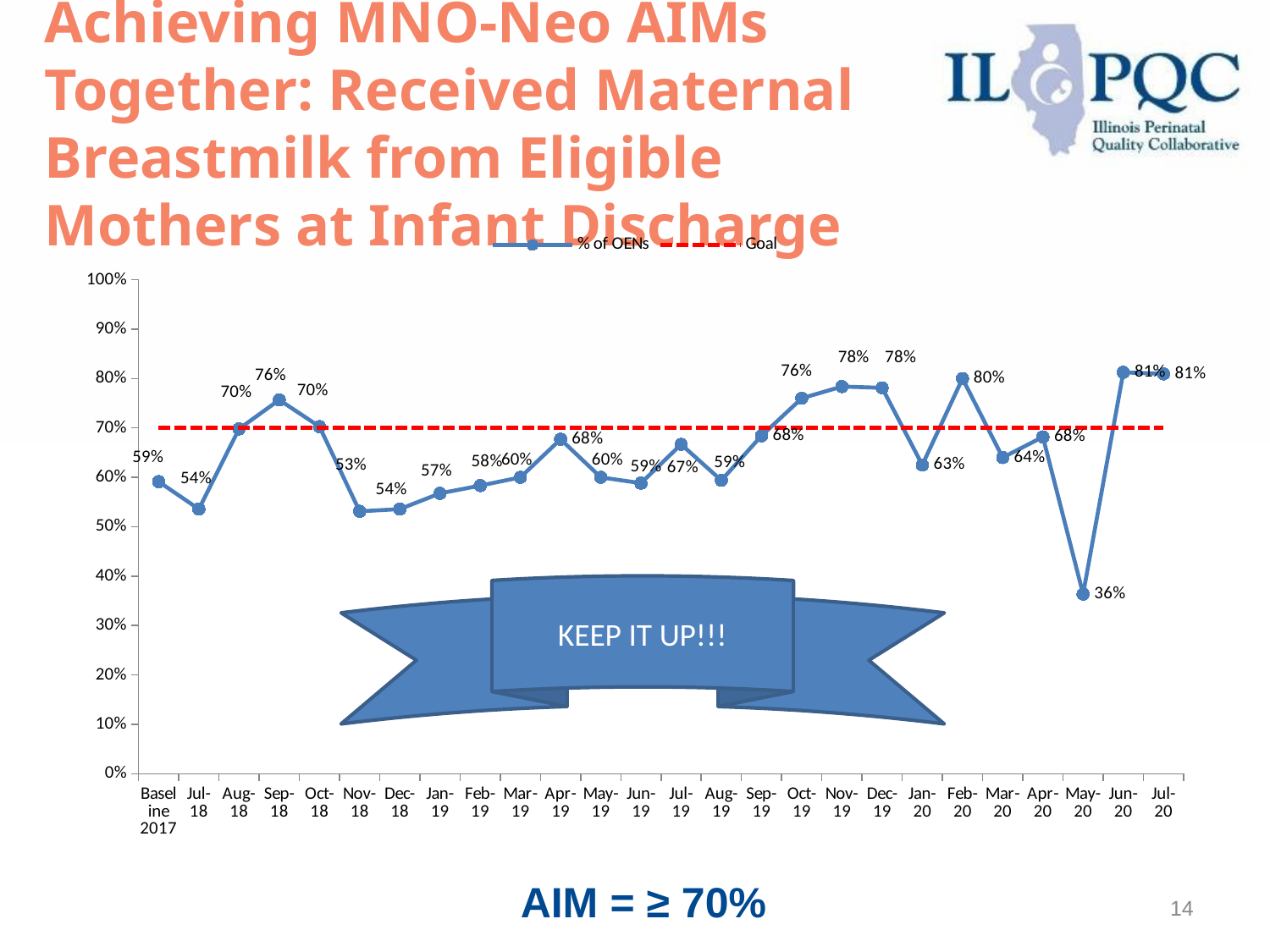
What is the difference between the % of OENs values for Jun-20 and May-20? 45 percentage points Is the % of OENs value for Dec-19 greater or less than 70%? greater What is the % of OENs value for the Baseline 2017 point? 59% What kind of chart is shown on the slide? line chart Which is larger, the % of OENs value for Oct-19 or for Jan-20? Oct-19 What is the % of OENs value for Nov-18? 53% How many series does the legend list? 2 What is the difference between the % of OENs values for Feb-20 and Mar-20? 16 percentage points Which month has the lowest % of OENs value? May-20 How many data points are plotted on the % of OENs line? 26 What is the % of OENs value for May-20? 36% What is the % of OENs value for Sep-18? 76%